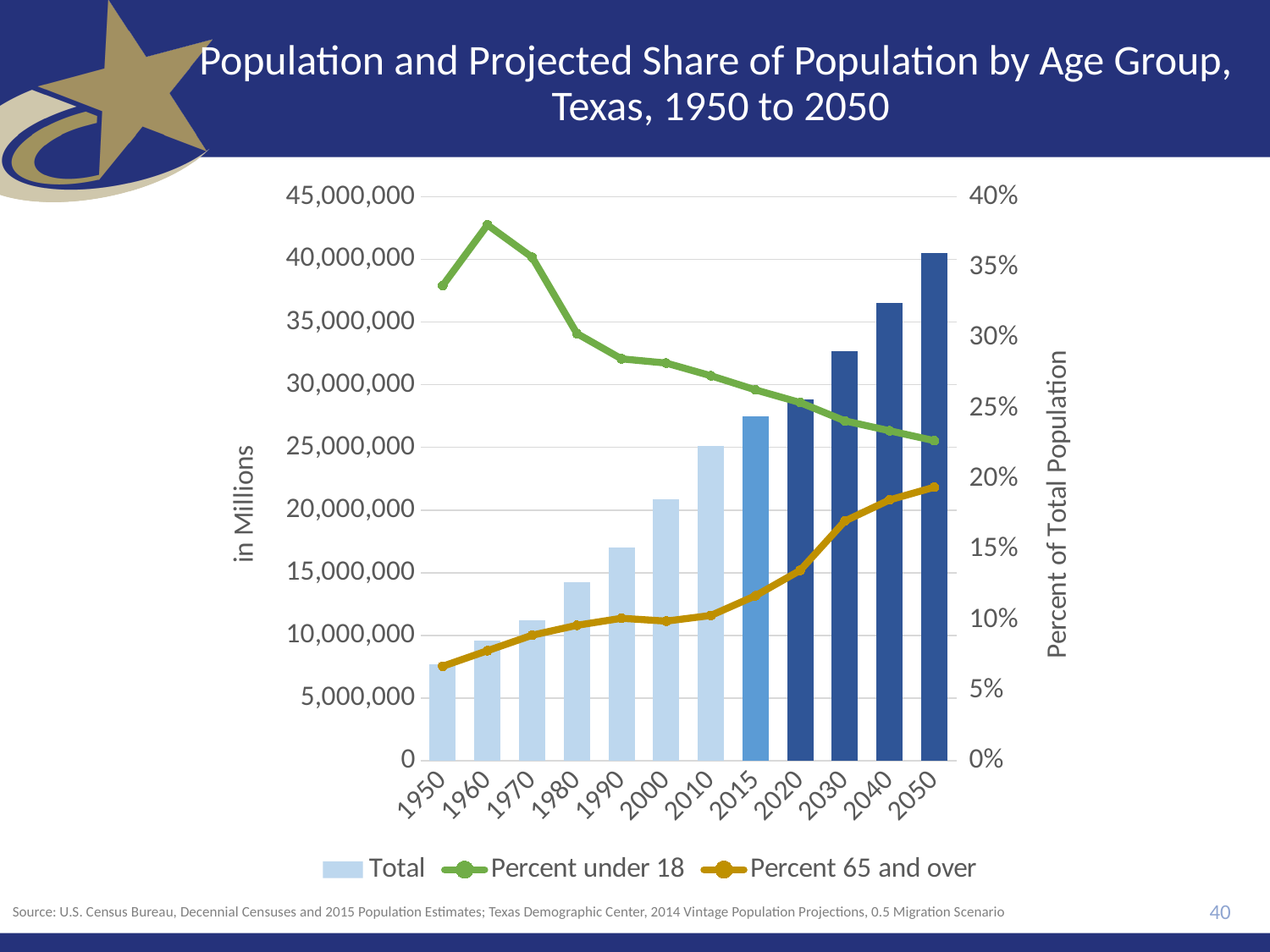
Is the Total population value for 2050 greater or less than 35,000,000? greater How many series does the legend list? 3 How many years are shown along the x axis? 12 What kind of chart is shown on the slide? A combination bar and line chart In which year does the Percent under 18 line reach its highest point? 1960 Is the Total population value for 1950 greater or less than 10,000,000? less Is the Percent 65 and over value for 1950 greater or less than 10%? less Which year has the highest Total population bar? 2050 Which year has the lowest Total population bar? 1950 Does the Percent 65 and over line rise or fall from 1950 to 2050? rise In 1950, which is larger: Percent under 18 or Percent 65 and over? Percent under 18